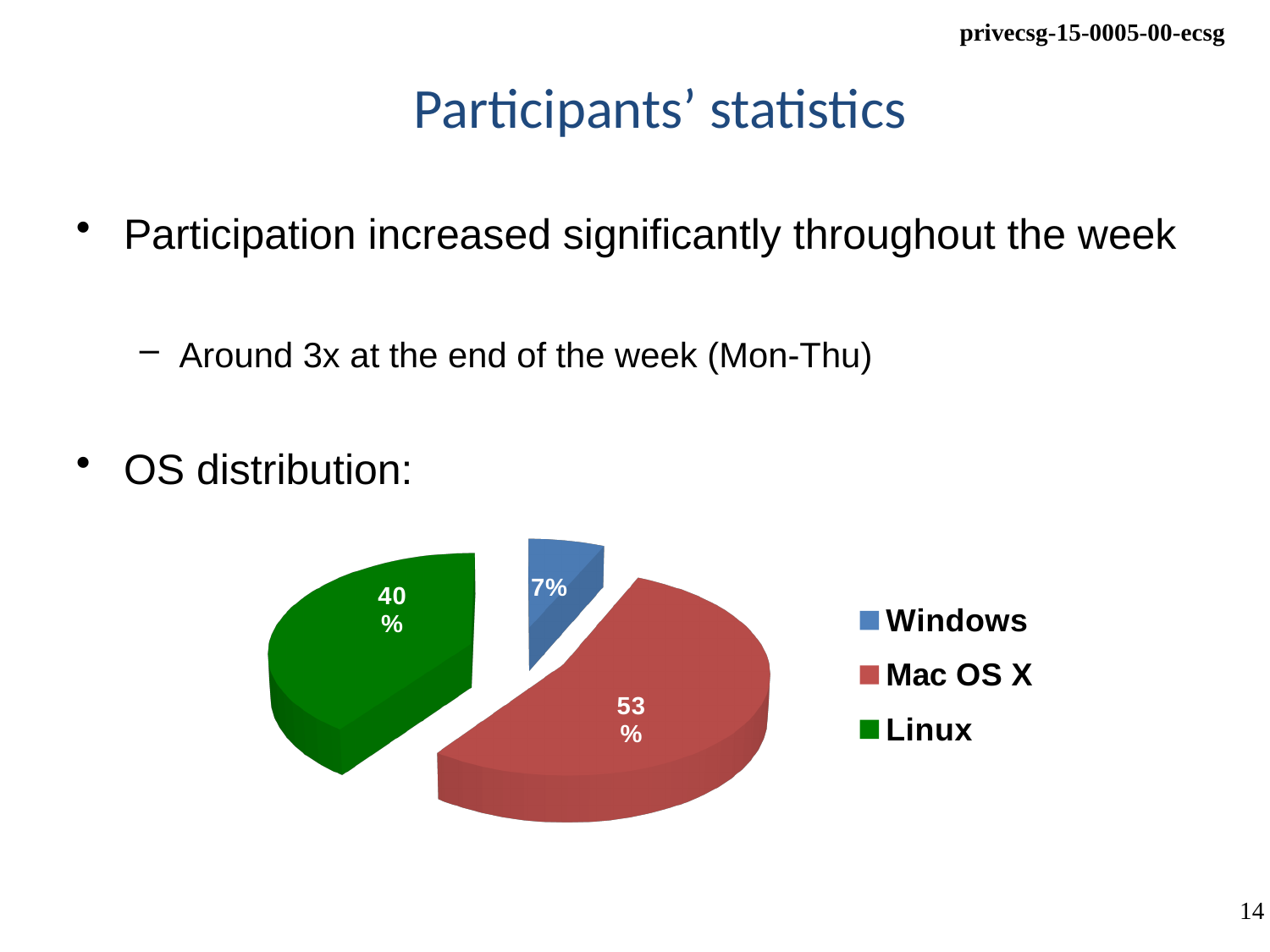
What share of the pie does Linux have? 40% Which is larger, the Linux slice or the Windows slice? Linux How many slices does the pie chart have? 3 What share of the pie does Mac OS X have? 53% How many entries does the legend list? 3 What share of the pie does Windows have? 7% What kind of chart is shown on the slide? pie chart Which operating system has the smallest slice of the pie? Windows What is the difference in percentage points between the Mac OS X and Linux slices? 13 What is the difference in percentage points between the Linux and Windows slices? 33 Which operating system has the largest slice of the pie? Mac OS X What colour is the Linux slice in the pie chart? green